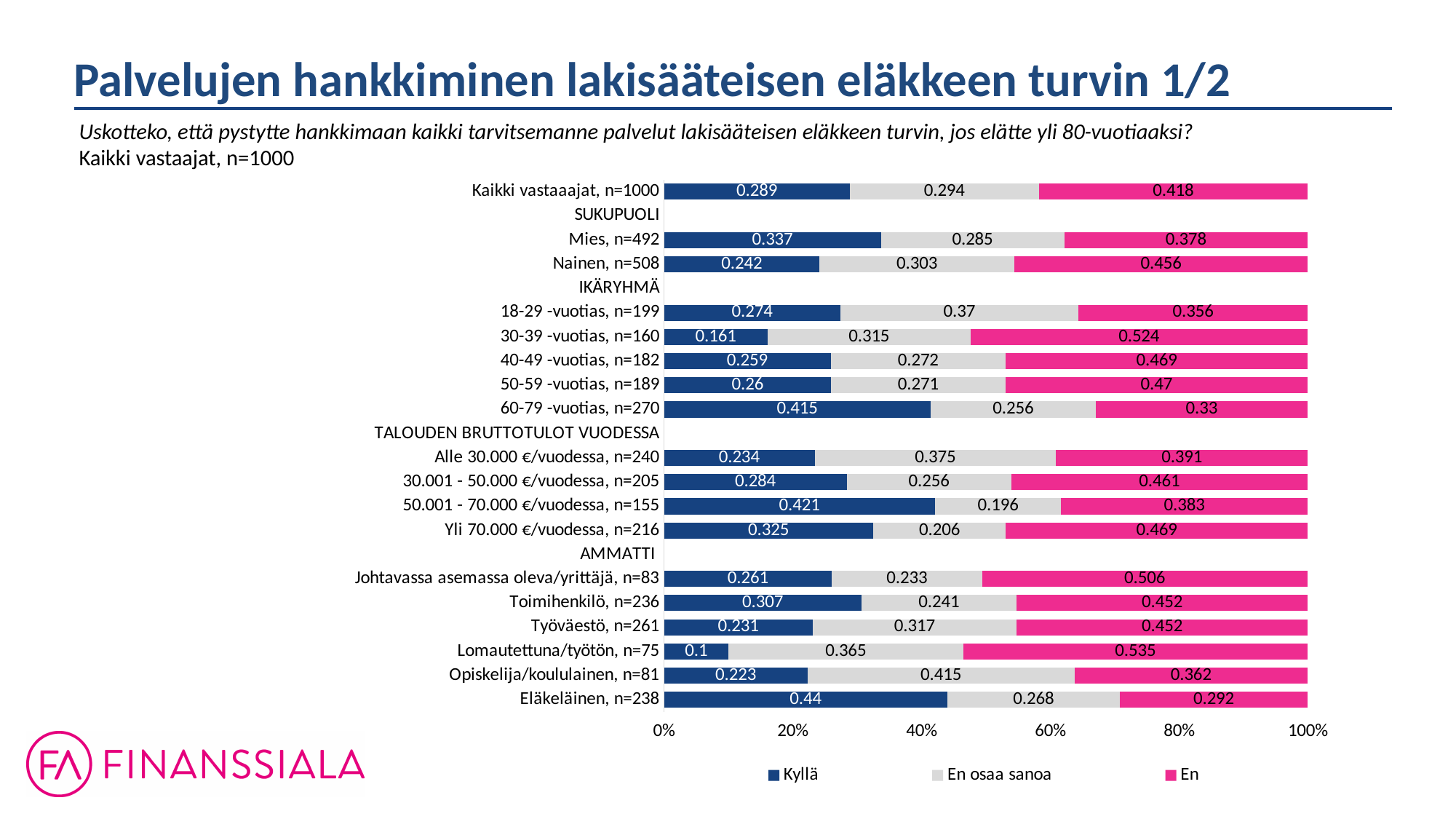
Which has the larger En value, Mies, n=492 or Nainen, n=508? Nainen, n=508 Which category has the highest Kyllä value? Eläkeläinen, n=238 Is the Kyllä value for Eläkeläinen, n=238 greater or less than 40%? greater What is the En osaa sanoa value for Opiskelija/koululainen, n=81? 0.415 What is the Kyllä value for Mies, n=492? 0.337 Which category has the lowest En value? Eläkeläinen, n=238 What is the Kyllä value for Kaikki vastaaajat, n=1000? 0.289 How many series does the legend list? 3 Which category has the lowest Kyllä value? Lomautettuna/työtön, n=75 What kind of chart is shown on the slide? stacked bar chart What is the En value for 30-39 -vuotias, n=160? 0.524 What is the difference between the Kyllä values for Mies, n=492 and Nainen, n=508? 0.095